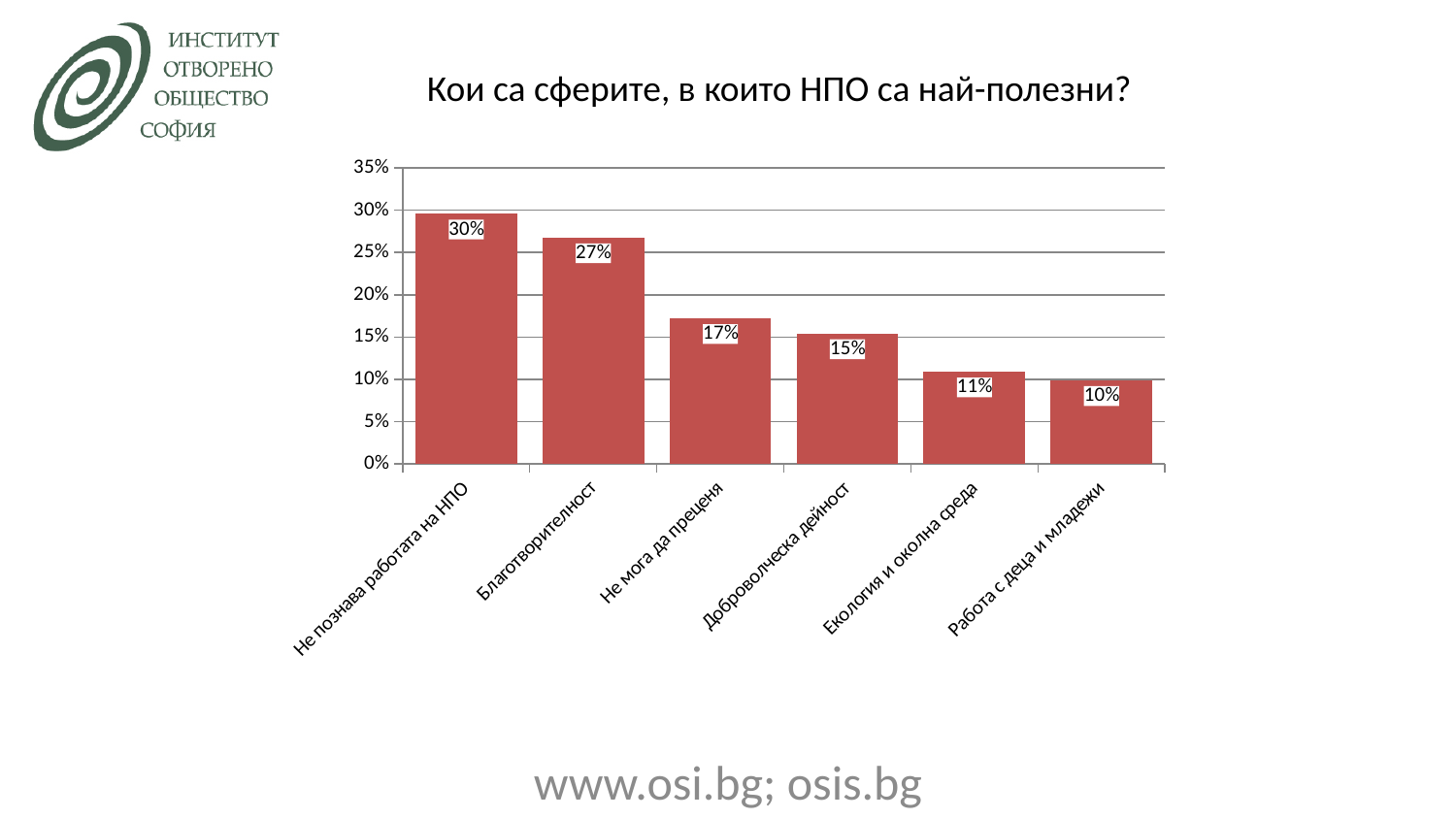
What is the difference between the values for "Не познава работата на НПО" and "Благотворителност"? 3% Which category has the lowest value? Работа с деца и младежи What is the value for "Екология и околна среда"? 11% Which category has the highest value? Не познава работата на НПО What is the difference between the values for "Не мога да преценя" and "Работа с деца и младежи"? 7% What is the title of the chart? Кои са сферите, в които НПО са най-полезни? Which is larger, the value for "Не мога да преценя" or the value for "Доброволческа дейност"? Не мога да преценя What is the value for "Доброволческа дейност"? 15% Is the value for "Благотворителност" greater or less than 25%? greater What is the value for "Благотворителност"? 27% What kind of chart is shown on the slide? bar chart How many categories are shown in the chart? 6